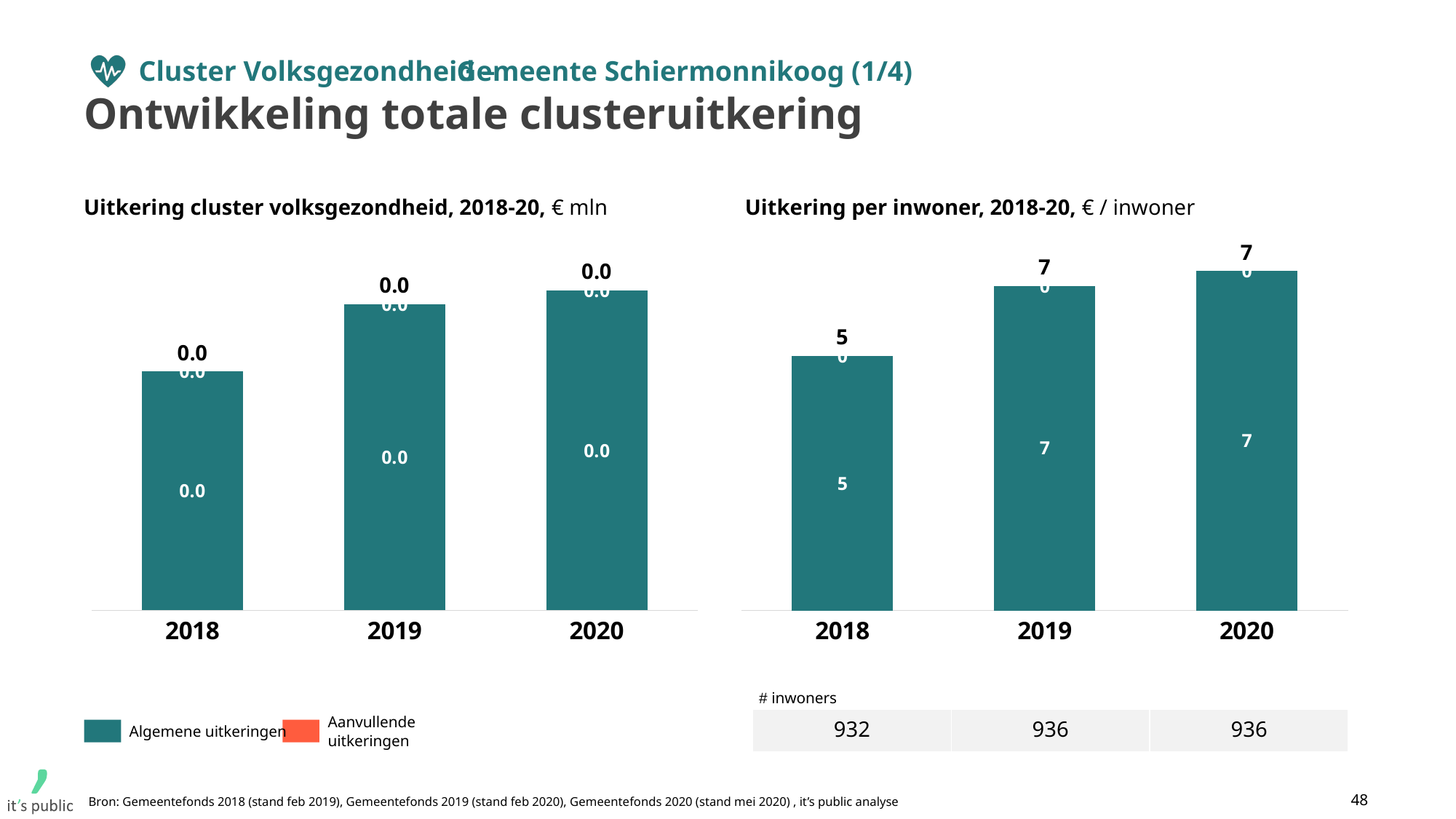
What are the two series named in the legend of the left chart? Algemene uitkeringen and Aanvullende uitkeringen How many years are shown on the x axis of the chart 'Uitkering cluster volksgezondheid, 2018-20'? 3 In the chart 'Uitkering per inwoner, 2018-20', what is the total value shown for 2018? 5 In the chart 'Uitkering per inwoner, 2018-20', is the value for 2019 larger or smaller than the value for 2018? larger What kind of chart is 'Uitkering per inwoner, 2018-20'? bar chart In the chart 'Uitkering per inwoner, 2018-20', what is the difference between the 2019 value and the 2018 value? 2 In the chart 'Uitkering per inwoner, 2018-20', which year has the lowest value? 2018 In the chart 'Uitkering per inwoner, 2018-20', do the values rise or fall from 2018 to 2020? rise In the chart 'Uitkering per inwoner, 2018-20', what is the total value shown for 2019? 7 How many series does the legend on the left chart list? 2 In the chart 'Uitkering per inwoner, 2018-20', what is the total value shown for 2020? 7 In the chart 'Uitkering cluster volksgezondheid, 2018-20', what total value is labelled above the 2020 bar? 0.0